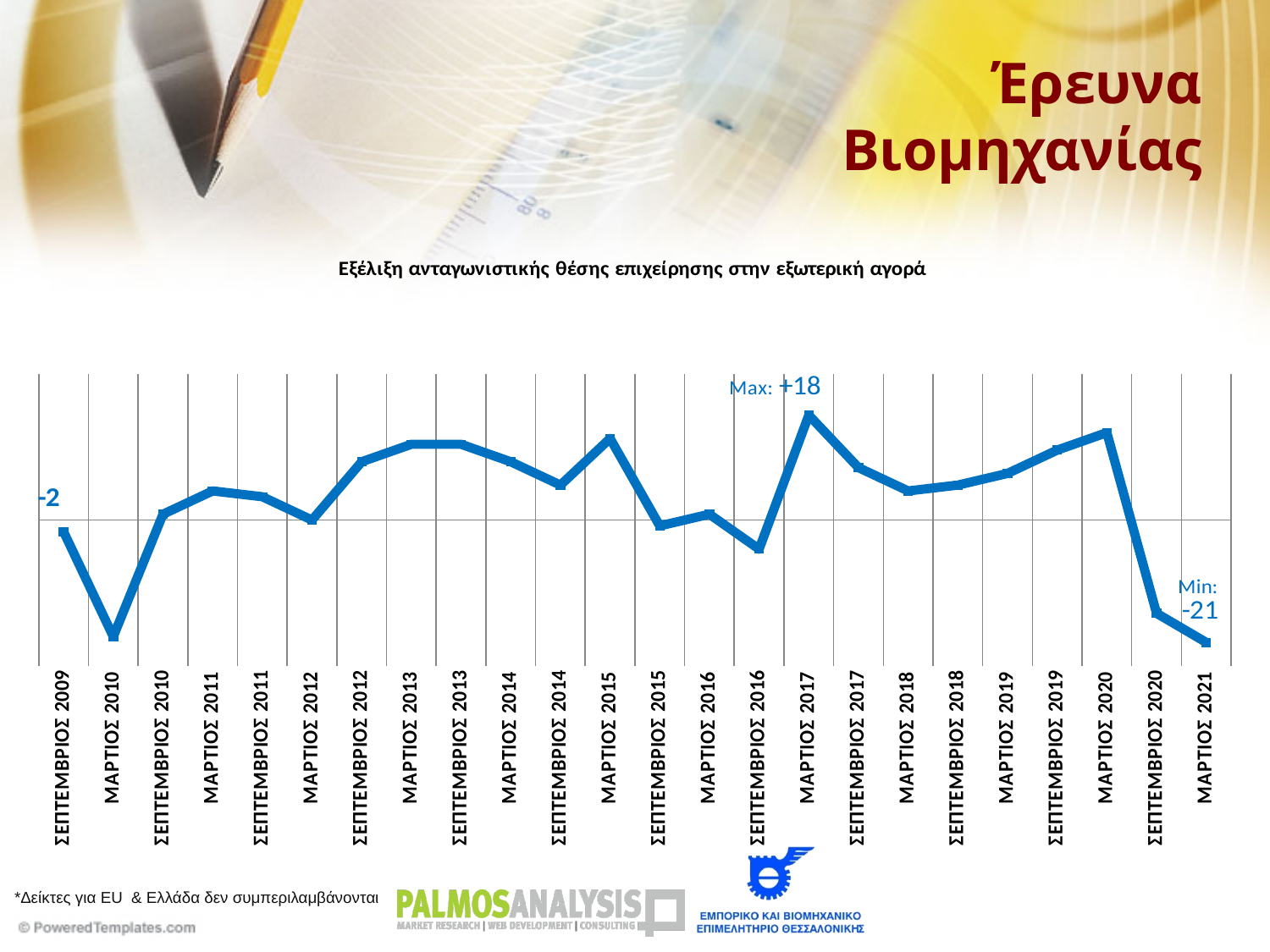
What kind of chart is shown on the slide? Line chart What is the value labelled as the minimum, at ΜΑΡΤΙΟΣ 2021? -21 What value is labelled for ΣΕΠΤΕΜΒΡΙΟΣ 2009? -2 What is the difference between the maximum value (+18) and the minimum value (-21)? 39 What is the difference between the value for ΣΕΠΤΕΜΒΡΙΟΣ 2009 and the value for ΜΑΡΤΙΟΣ 2021? 19 Which period has the highest value on the chart? ΜΑΡΤΙΟΣ 2017 What is the value labelled as the maximum, at ΜΑΡΤΙΟΣ 2017? +18 Which period has the lowest value on the chart? ΜΑΡΤΙΟΣ 2021 Does the line rise or fall from ΜΑΡΤΙΟΣ 2020 to ΜΑΡΤΙΟΣ 2021? Fall Which is larger, the value for ΜΑΡΤΙΟΣ 2015 or the value for ΣΕΠΤΕΜΒΡΙΟΣ 2016? ΜΑΡΤΙΟΣ 2015 How many time periods are plotted on the x axis? 24 What is the title of the chart? Εξέλιξη ανταγωνιστικής θέσης επιχείρησης στην εξωτερική αγορά